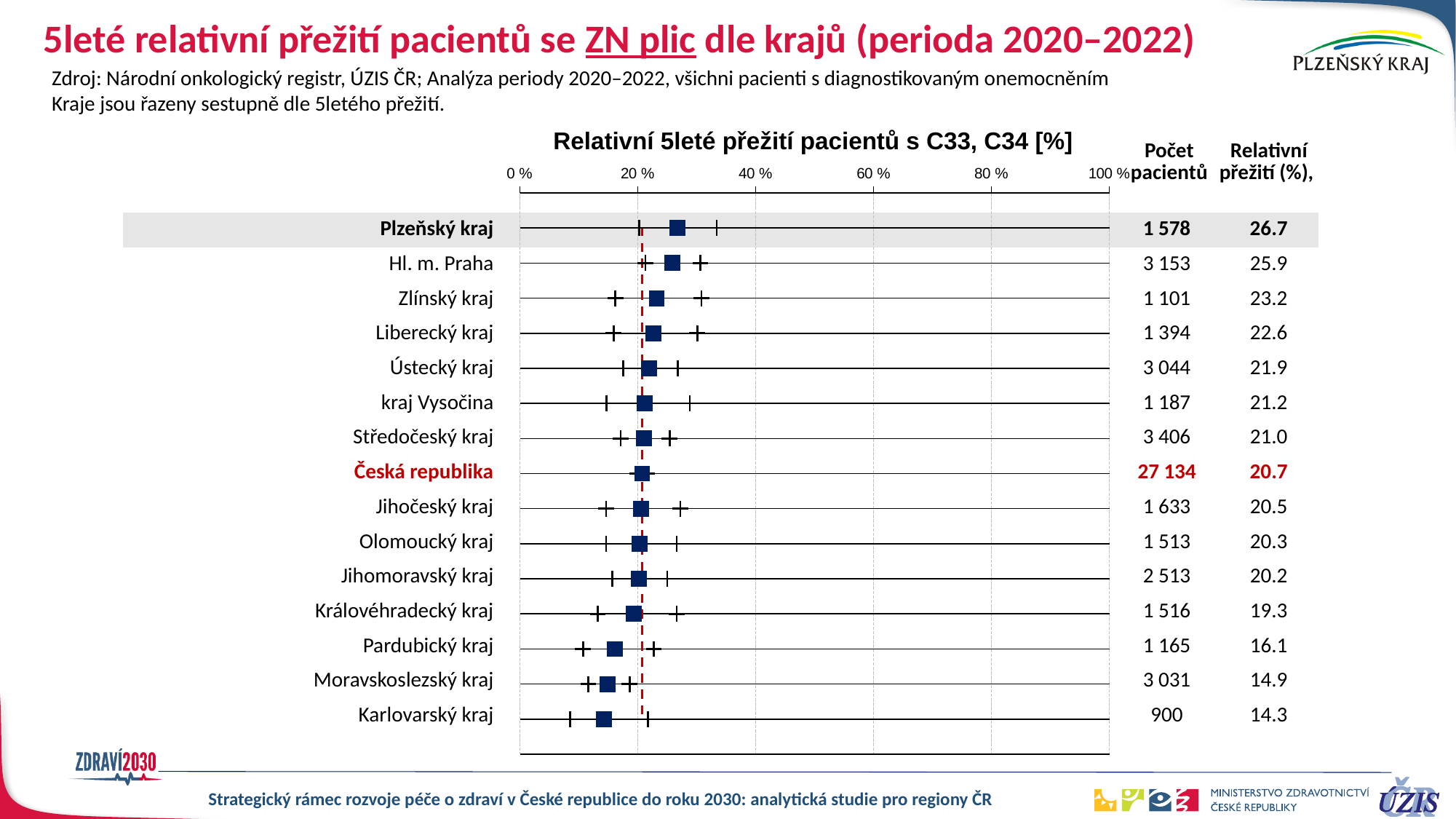
Which region has the highest relative 5-year survival? Plzeňský kraj What is the relative 5-year survival (%) for Plzeňský kraj? 26.7 How many patients (Počet pacientů) are listed for Česká republika? 27 134 Do the relative 5-year survival values rise or fall going down the list of regions? fall What is the relative 5-year survival (%) for Karlovarský kraj? 14.3 What is the difference in relative 5-year survival (%) between Plzeňský kraj and Česká republika? 6.0 What is the title of the chart? Relativní 5leté přežití pacientů s C33, C34 [%] How many rows (regions including Česká republika) are plotted in the chart? 15 Which has a higher relative 5-year survival, Pardubický kraj or Moravskoslezský kraj? Pardubický kraj Is the relative 5-year survival for Karlovarský kraj greater or less than 20 %? less Which region has the lowest relative 5-year survival? Karlovarský kraj What is the difference in relative 5-year survival (%) between Plzeňský kraj and Karlovarský kraj? 12.4